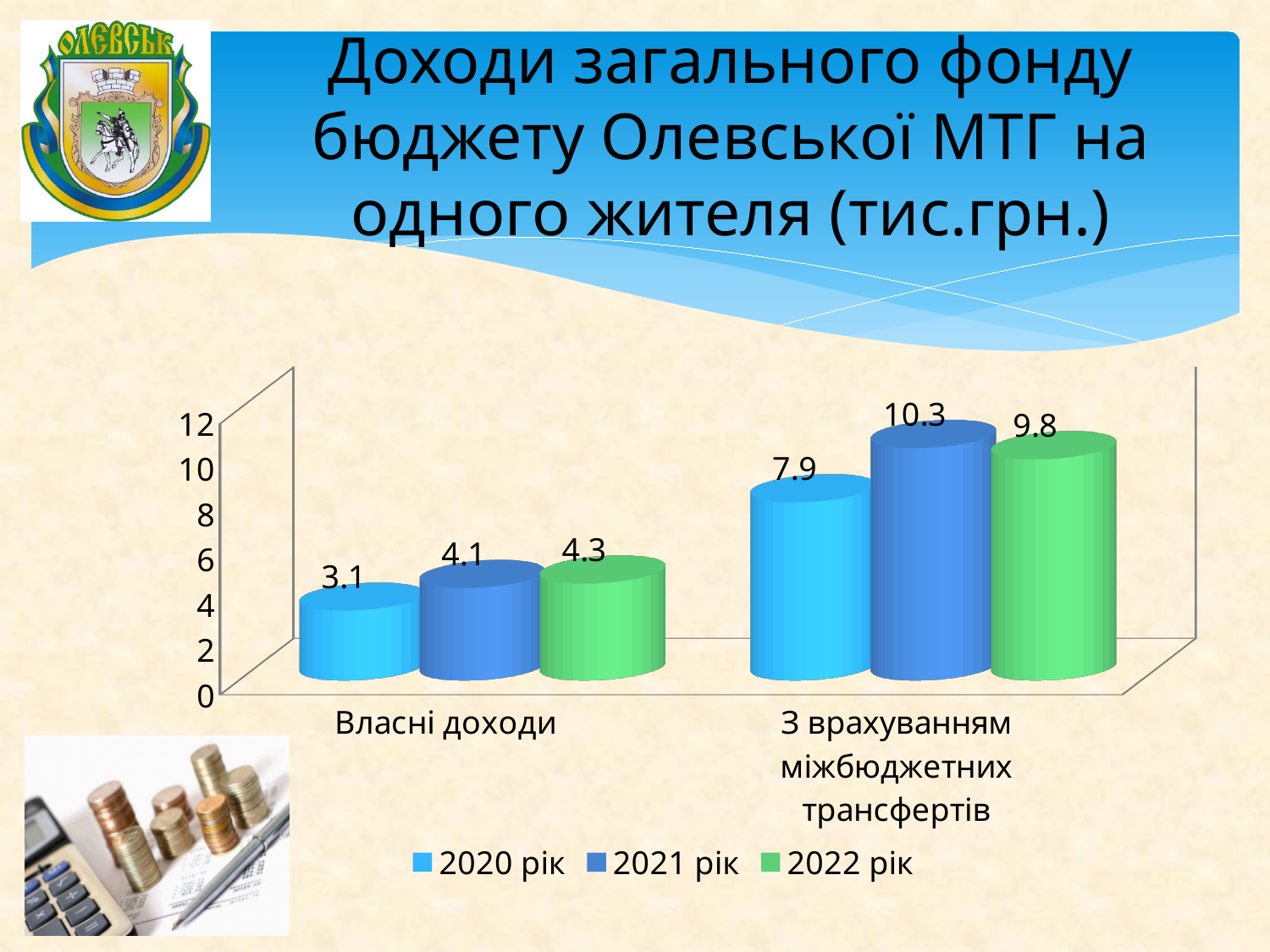
What is the title of the chart on the slide? Доходи загального фонду бюджету Олевської МТГ на одного жителя (тис.грн.) How many categories are shown on the x axis? 2 Which year has the lowest value in the Власні доходи category? 2020 рік What is the value for 2022 рік in the З врахуванням міжбюджетних трансфертів category? 9.8 What is the difference between the 2021 рік and 2020 рік values in the З врахуванням міжбюджетних трансфертів category? 2.4 What kind of chart is shown on the slide? bar chart Which is larger: the 2022 рік value for Власні доходи or the 2021 рік value for Власні доходи? 2022 рік What is the value for 2021 рік in the Власні доходи category? 4.1 Is the value for 2020 рік in the З врахуванням міжбюджетних трансфертів category greater or less than 6? greater What is the value for 2020 рік in the Власні доходи category? 3.1 How many series does the legend list? 3 Which year has the highest value in the З врахуванням міжбюджетних трансфертів category? 2021 рік